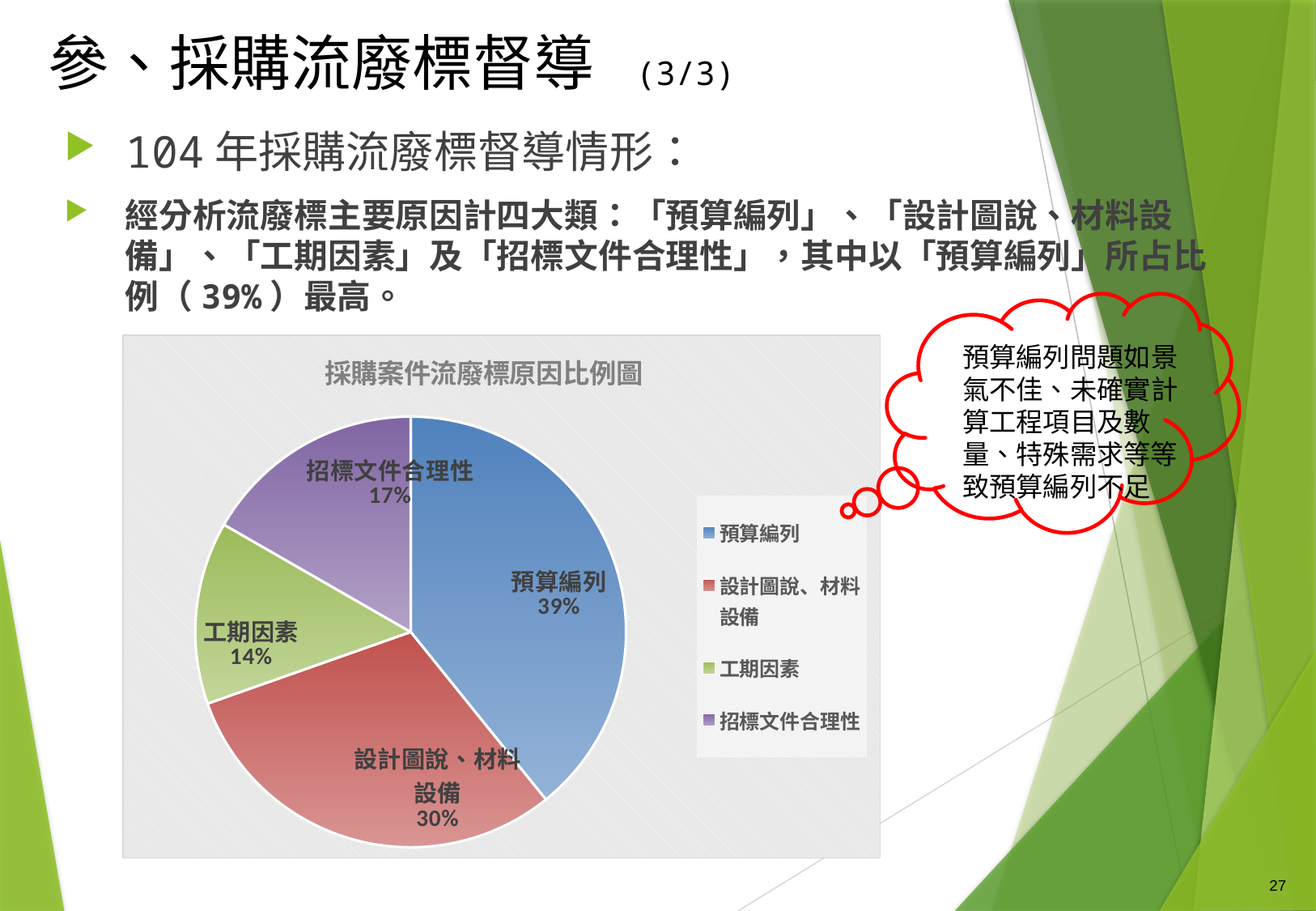
Which is larger, the share for 招標文件合理性 or the share for 工期因素? 招標文件合理性 What share of the pie does 預算編列 account for? 39% Which category has the largest share of the pie? 預算編列 What is the difference between the shares of 預算編列 and 設計圖說、材料設備? 9% What is the title of the chart? 採購案件流廢標原因比例圖 What is the value shown for 招標文件合理性? 17% Which colour represents 工期因素 in the legend? green What type of chart is shown on the slide? pie chart What is the value shown for 設計圖說、材料設備? 30% Which category has the smallest share of the pie? 工期因素 What is the value shown for 工期因素? 14% How many categories are shown in the pie chart? 4